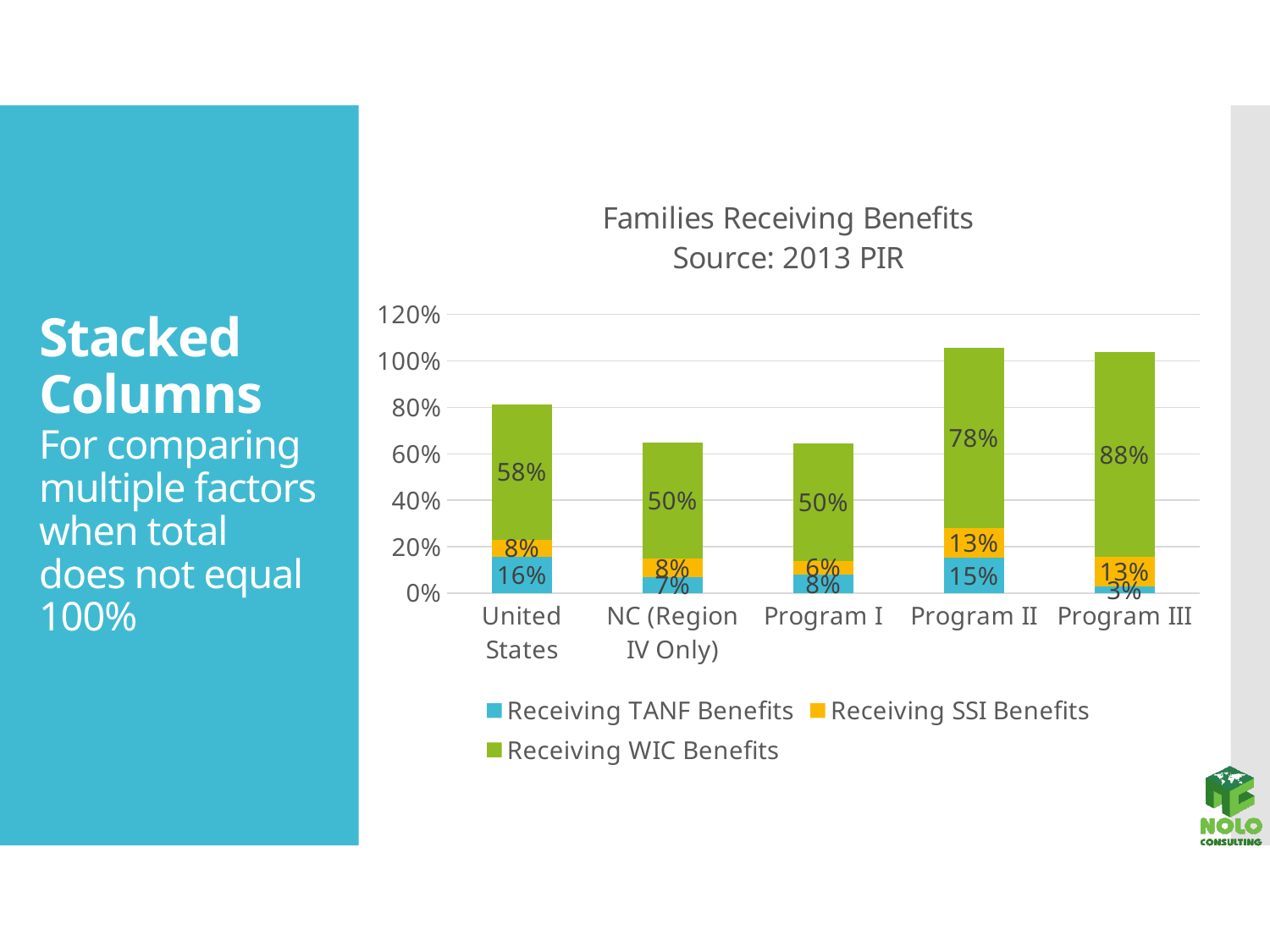
Which category has the lowest value for Receiving TANF Benefits? Program III What is the value for Receiving WIC Benefits for Program III? 88% Is the total of the stacked bar for Program II greater or less than 100%? greater Which is larger, the Receiving TANF Benefits value for United States or for Program II? United States What is the total of the stacked bar for United States? 82% What is the difference between the Receiving WIC Benefits values for Program III and Program II? 10% What is the value for Receiving TANF Benefits for United States? 16% Which category has the highest value for Receiving WIC Benefits? Program III What kind of chart is shown on the slide? Stacked bar chart How many series does the legend list? 3 How many categories are shown on the x axis? 5 What is the value for Receiving SSI Benefits for Program II? 13%